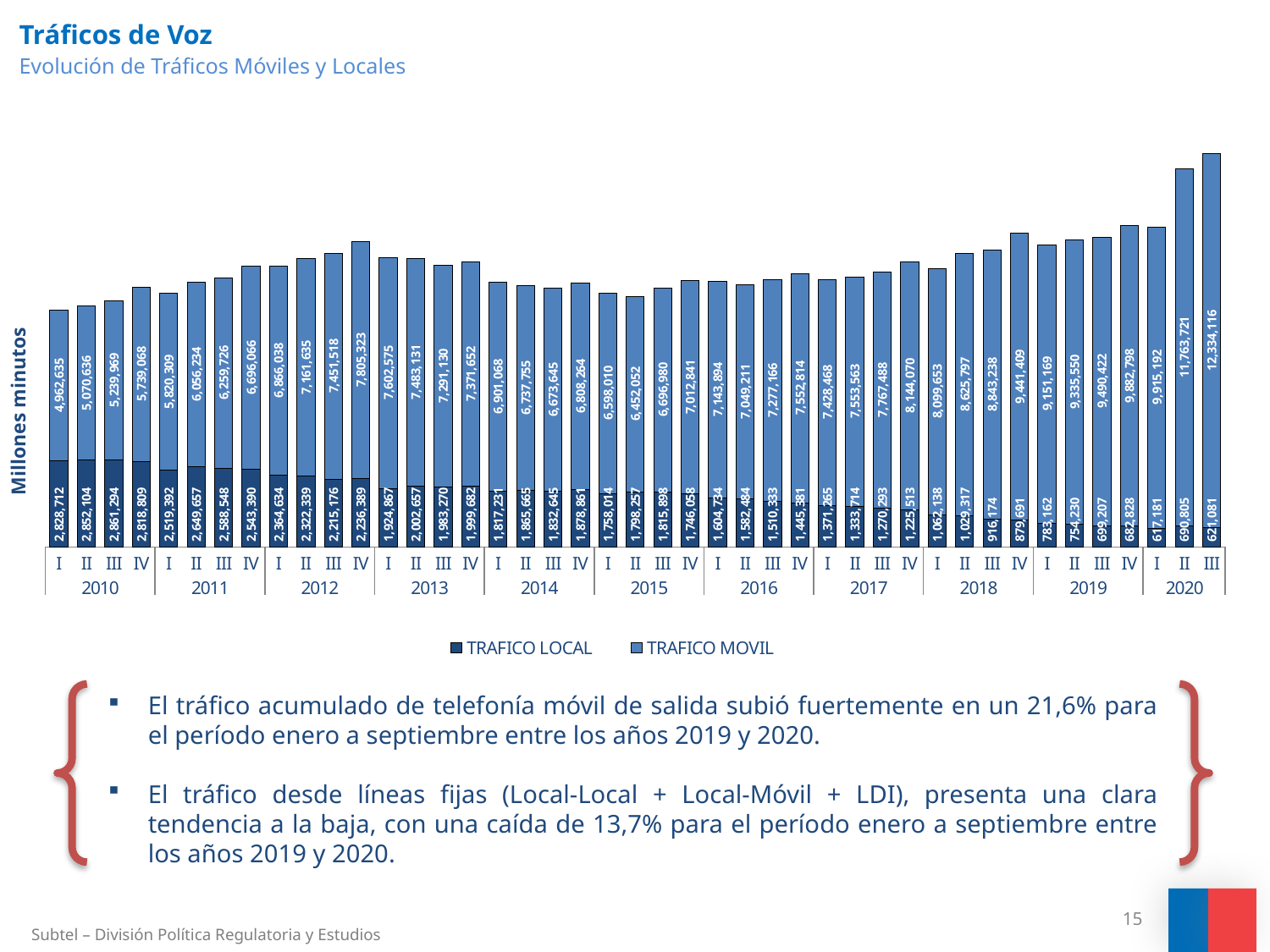
Which is larger, TRAFICO LOCAL in quarter I of 2010 or in quarter I of 2020? I 2010 What is the TRAFICO MOVIL value for quarter IV of 2013? 7,371,652 What are the two series named in the legend? TRAFICO LOCAL and TRAFICO MOVIL In which quarter is TRAFICO LOCAL lowest? I 2020 How many series does the legend list? 2 What type of chart is shown on the slide? Stacked bar chart In which quarter is TRAFICO MOVIL highest? III 2020 What is the TRAFICO MOVIL value for quarter III of 2020? 12,334,116 What is the TRAFICO LOCAL value for quarter I of 2010? 2,828,712 How many quarterly bars are plotted in the chart? 43 What is the difference between TRAFICO MOVIL in quarter III of 2020 and quarter II of 2020? 570,395 What is the total of the stacked bar for quarter III of 2020? 12,955,197